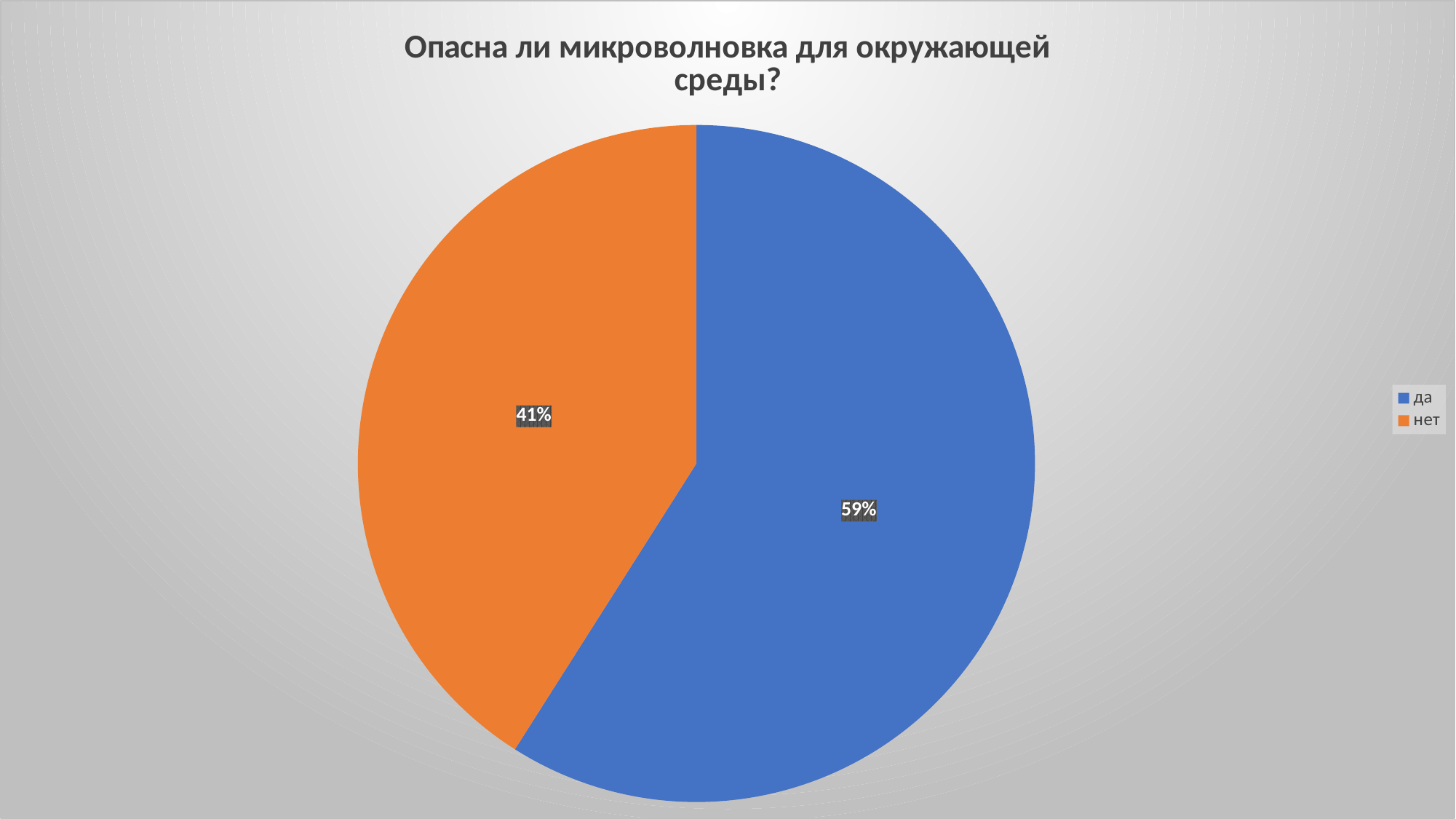
What colour is the "нет" slice? orange Is the share for "да" greater or less than 50%? greater Which category has the smallest slice of the pie? нет What is the title of the chart? Опасна ли микроволновка для окружающей среды? Which category has the largest slice of the pie? да Which slice is larger, "да" or "нет"? да What share of the pie does "да" represent? 59% What is the difference in percentage points between the "да" and "нет" slices? 18 What kind of chart is shown on the slide? pie chart How many categories are shown in the pie chart? 2 What share of the pie does "нет" represent? 41%